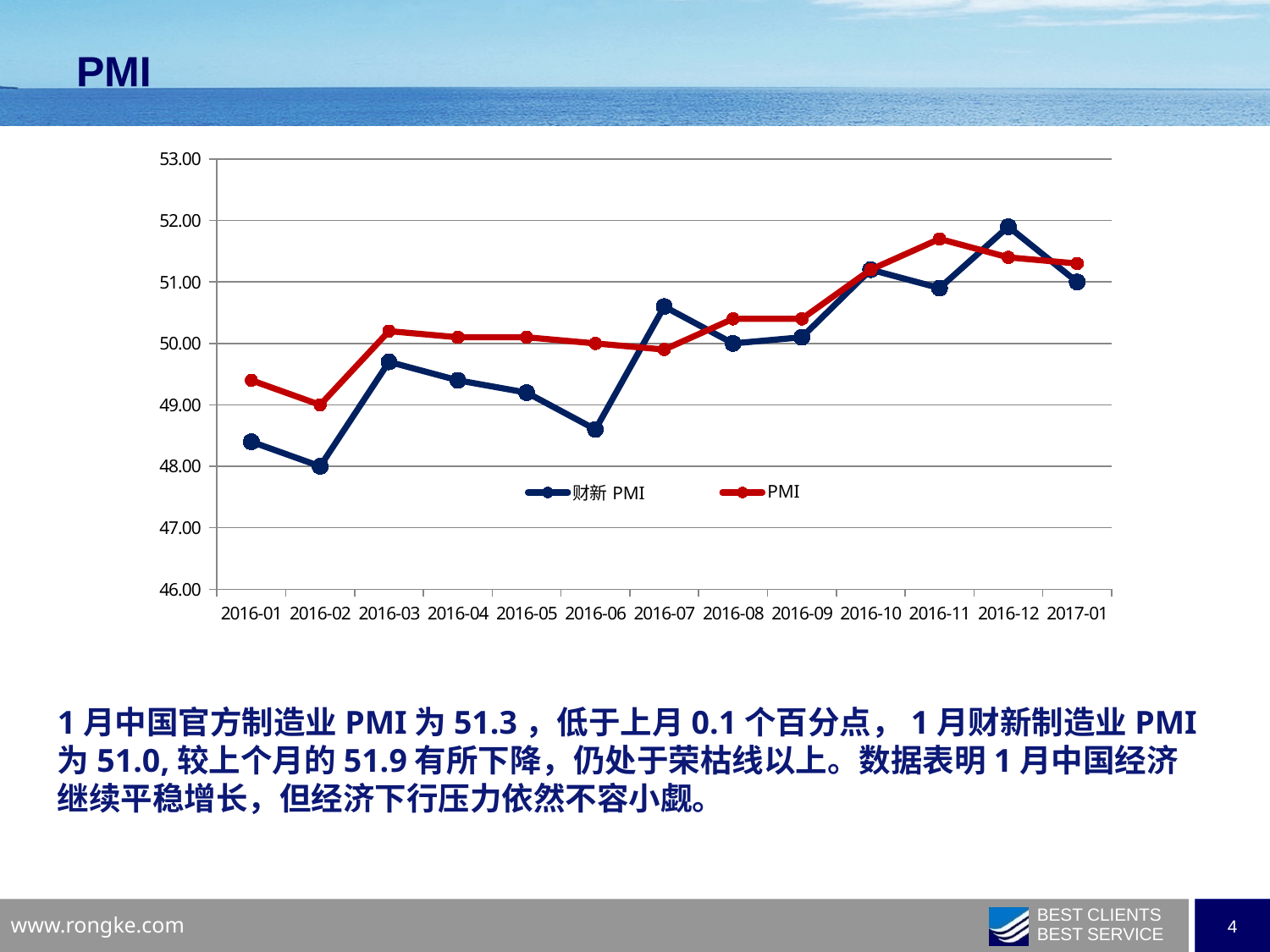
In 2016-06, which series is higher, 财新 PMI or PMI? PMI Is the value for 财新 PMI in 2016-01 greater or less than 49.00? less Overall, do the 财新 PMI values rise or fall from 2016-01 to 2017-01? rise How many months are plotted along the x axis? 13 Which month has the highest value for 财新 PMI? 2016-12 Which month has the lowest value for PMI (the red series)? 2016-02 Is the value for PMI in 2016-11 greater or less than 51.00? greater How many series does the legend list? 2 Which month has the lowest value for 财新 PMI? 2016-02 In 2016-07, which series is higher, 财新 PMI or PMI? 财新 PMI Which month has the highest value for PMI (the red series)? 2016-11 What kind of chart is shown on the slide? line chart